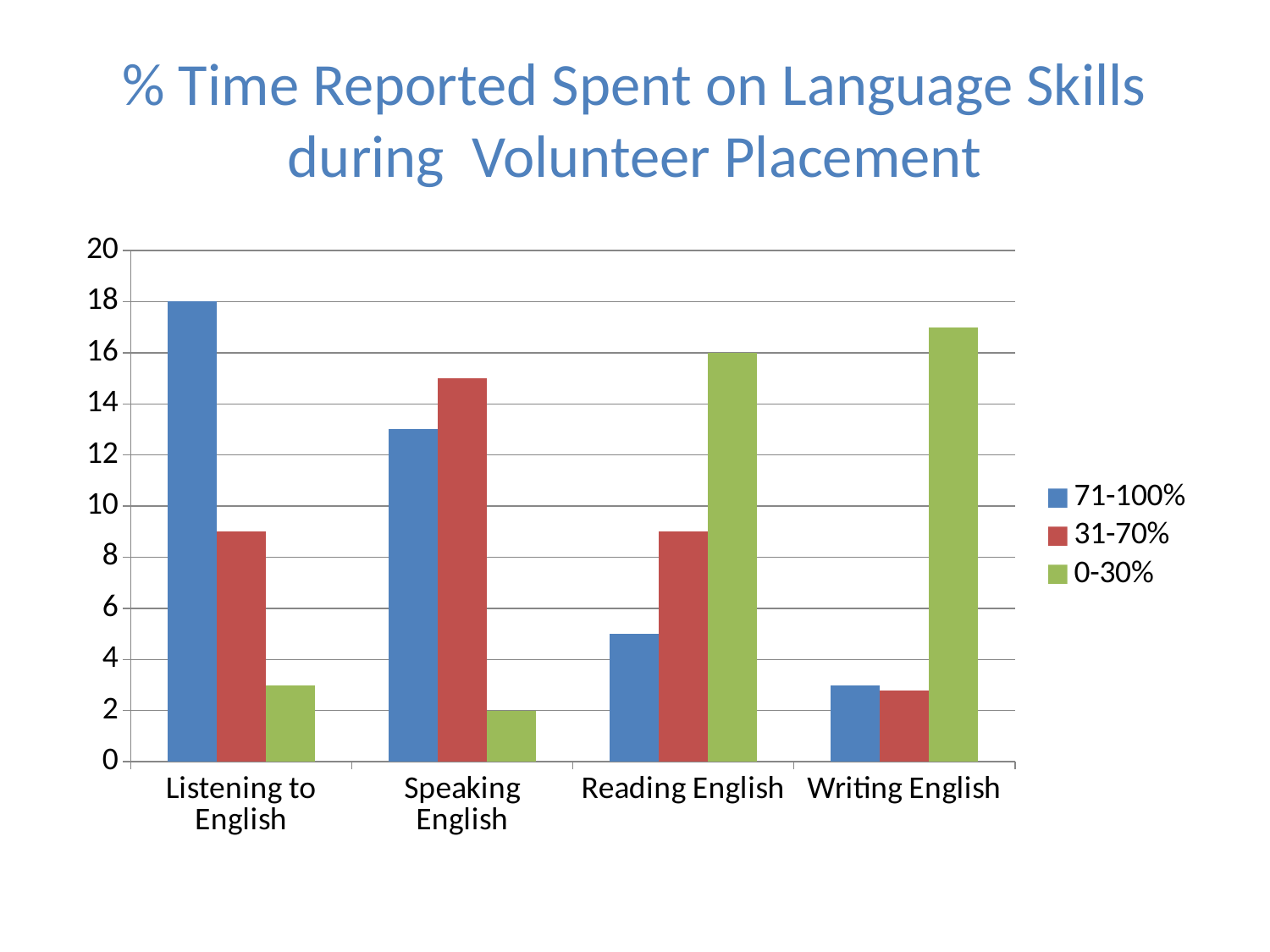
Which category has the highest 71-100% bar? Listening to English Do the 71-100% values rise or fall from Listening to English to Writing English? fall Is the value of the 71-100% bar for Reading English greater or less than 6? less Which category has the lowest 0-30% bar? Speaking English What is the value of the 0-30% bar for Reading English? 16 How many series does the legend list? 3 For Speaking English, which is larger: the 71-100% bar or the 31-70% bar? 31-70% What is the value of the 0-30% bar for Speaking English? 2 Is the value of the 0-30% bar for Writing English greater or less than 16? greater What is the difference between the 71-100% bar for Listening to English and the 0-30% bar for Reading English? 2 What is the value of the 71-100% bar for Listening to English? 18 How many categories are shown on the x axis? 4